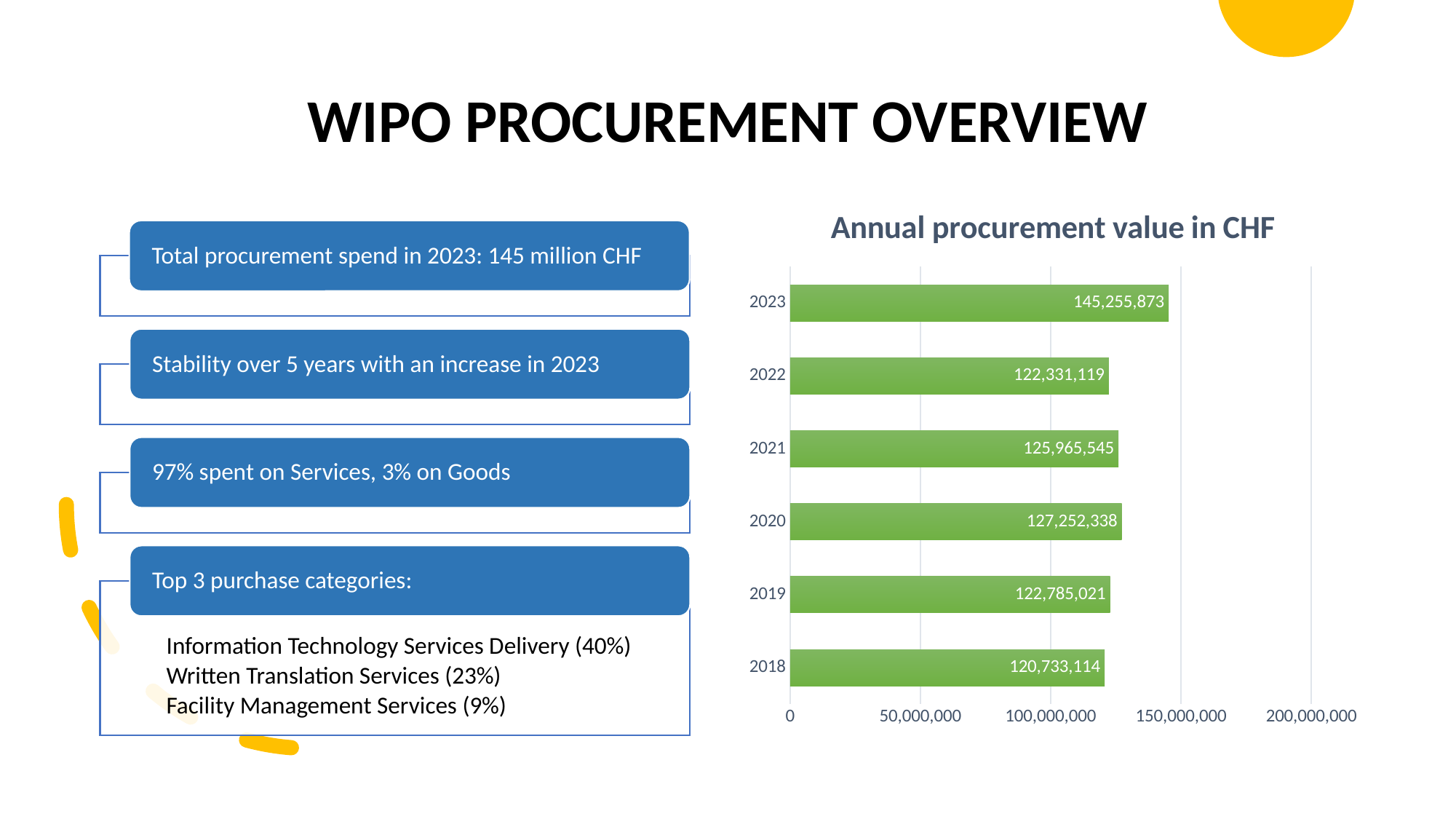
Is the annual procurement value for 2018 greater or less than 150,000,000? less Which year has a larger annual procurement value, 2021 or 2022? 2021 What kind of chart is used to show the annual procurement value in CHF? bar chart Which year has the highest annual procurement value? 2023 What is the difference between the annual procurement values for 2023 and 2022? 22,924,754 What is the annual procurement value in CHF for 2018? 120,733,114 What is the title of the chart on the slide? Annual procurement value in CHF How many years are shown in the annual procurement value chart? 6 What is the difference between the annual procurement values for 2020 and 2019? 4,467,317 What is the annual procurement value in CHF for 2020? 127,252,338 What is the annual procurement value in CHF for 2023? 145,255,873 Which year has the lowest annual procurement value? 2018